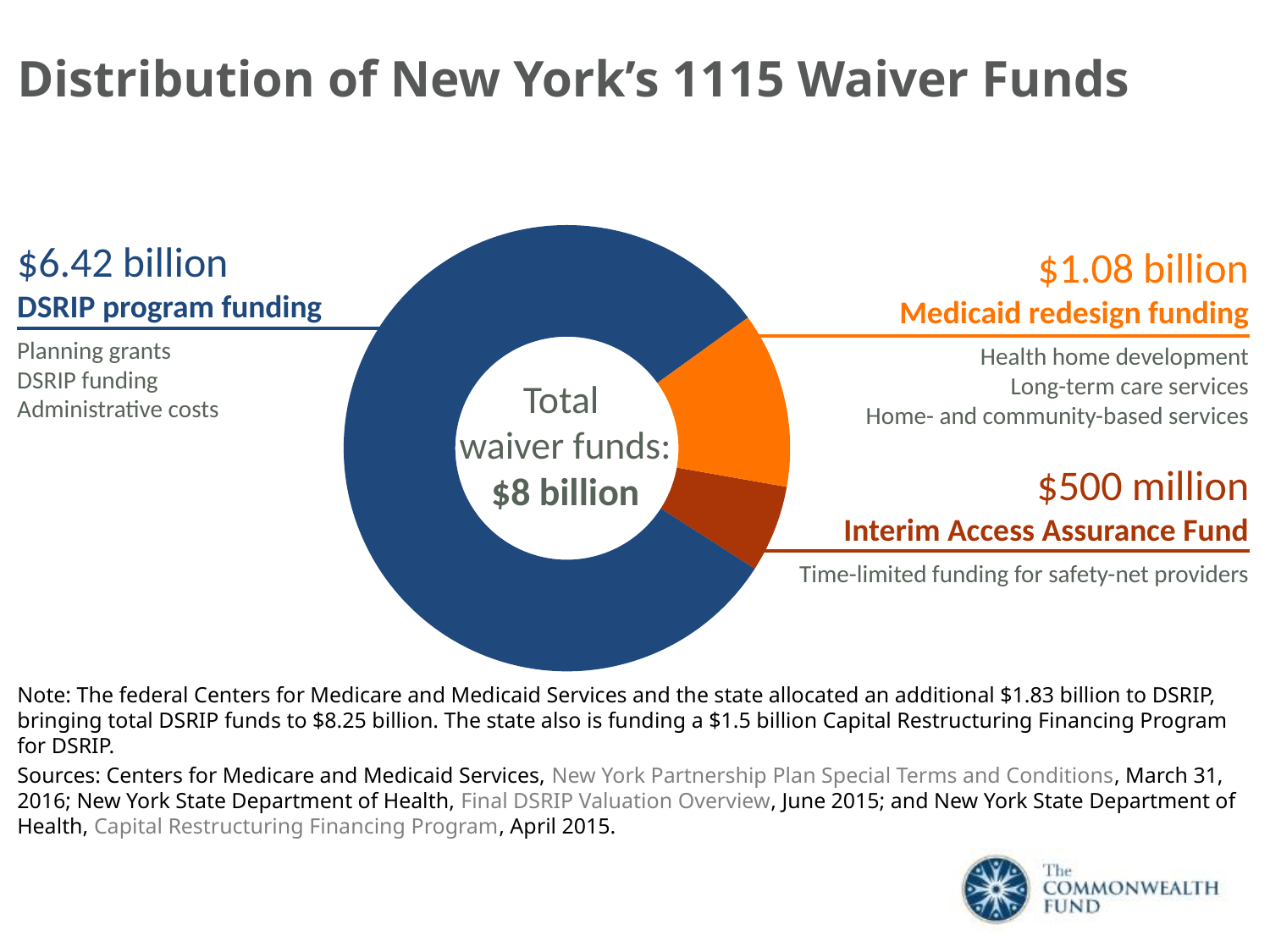
Which category receives the largest share of the waiver funds? DSRIP program funding What colour is the segment representing DSRIP program funding? Dark blue How many funding categories does the chart divide the waiver funds into? 3 Which is larger: Medicaid redesign funding or the Interim Access Assurance Fund? Medicaid redesign funding What is the total amount of waiver funds shown in the center of the chart? $8 billion Which category receives the smallest share of the waiver funds? Interim Access Assurance Fund How much of the waiver funds is allocated to Medicaid redesign funding? $1.08 billion What amount is allocated to the Interim Access Assurance Fund? $500 million What kind of chart is used to show the distribution of waiver funds? Donut (pie) chart How much more is allocated to Medicaid redesign funding than to the Interim Access Assurance Fund? $580 million How much more is allocated to DSRIP program funding than to Medicaid redesign funding? $5.34 billion How much of New York's 1115 waiver funds goes to DSRIP program funding? $6.42 billion